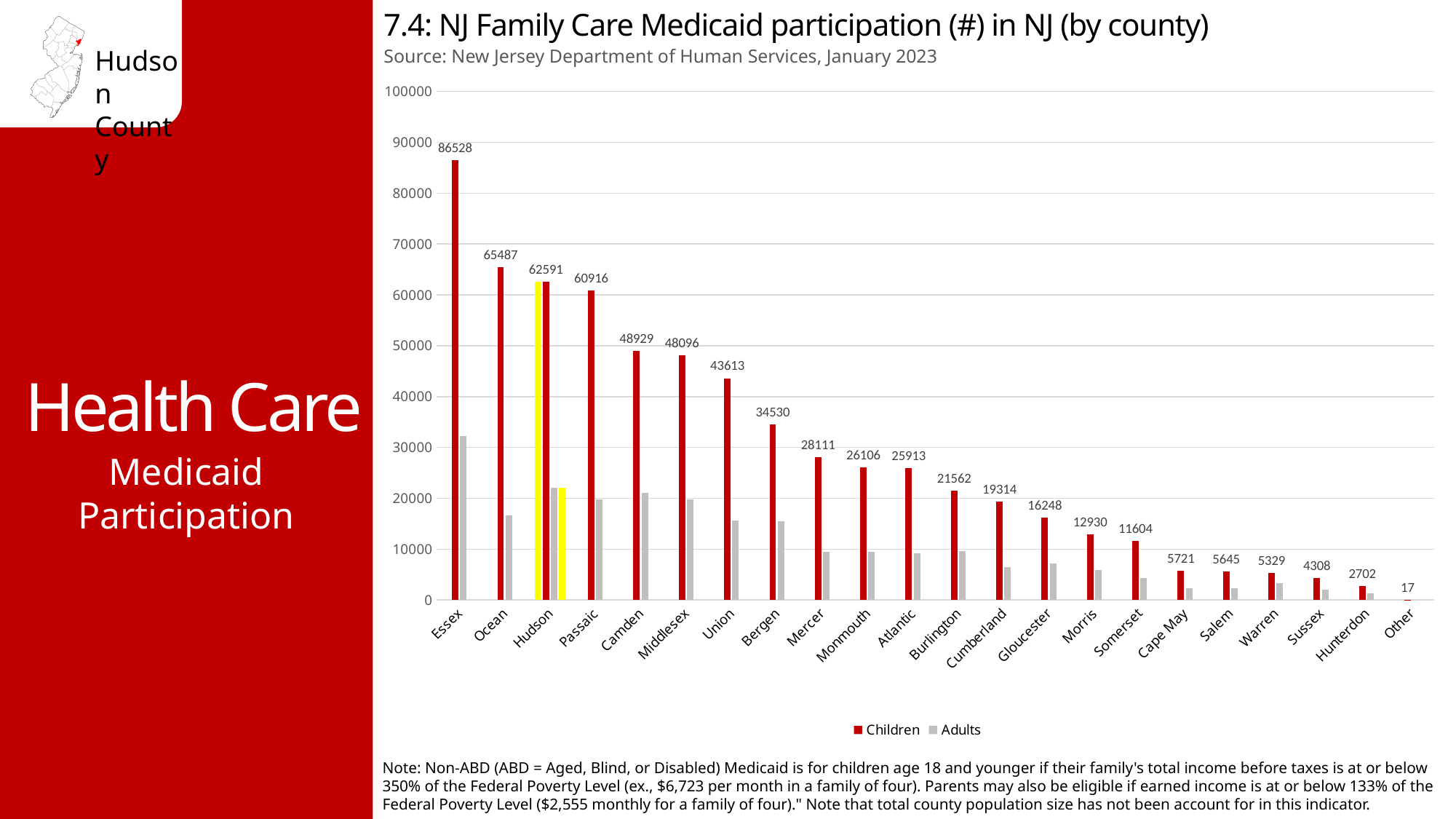
What is the difference between the Children values for Essex and Ocean? 21041 Is the Adults value for Ocean greater or less than 20000? less Is the Adults value for Essex greater or less than 30000? greater What is the Children value for Passaic? 60916 What is the Children value for Cape May? 5721 Which county has the highest Children value? Essex What is the Children value for Hudson? 62591 How many categories are shown on the x axis? 22 Which has a larger Children value, Camden or Union? Camden How many series does the legend list? 2 Which category has the lowest Children value? Other What kind of chart is shown on the slide? Bar chart